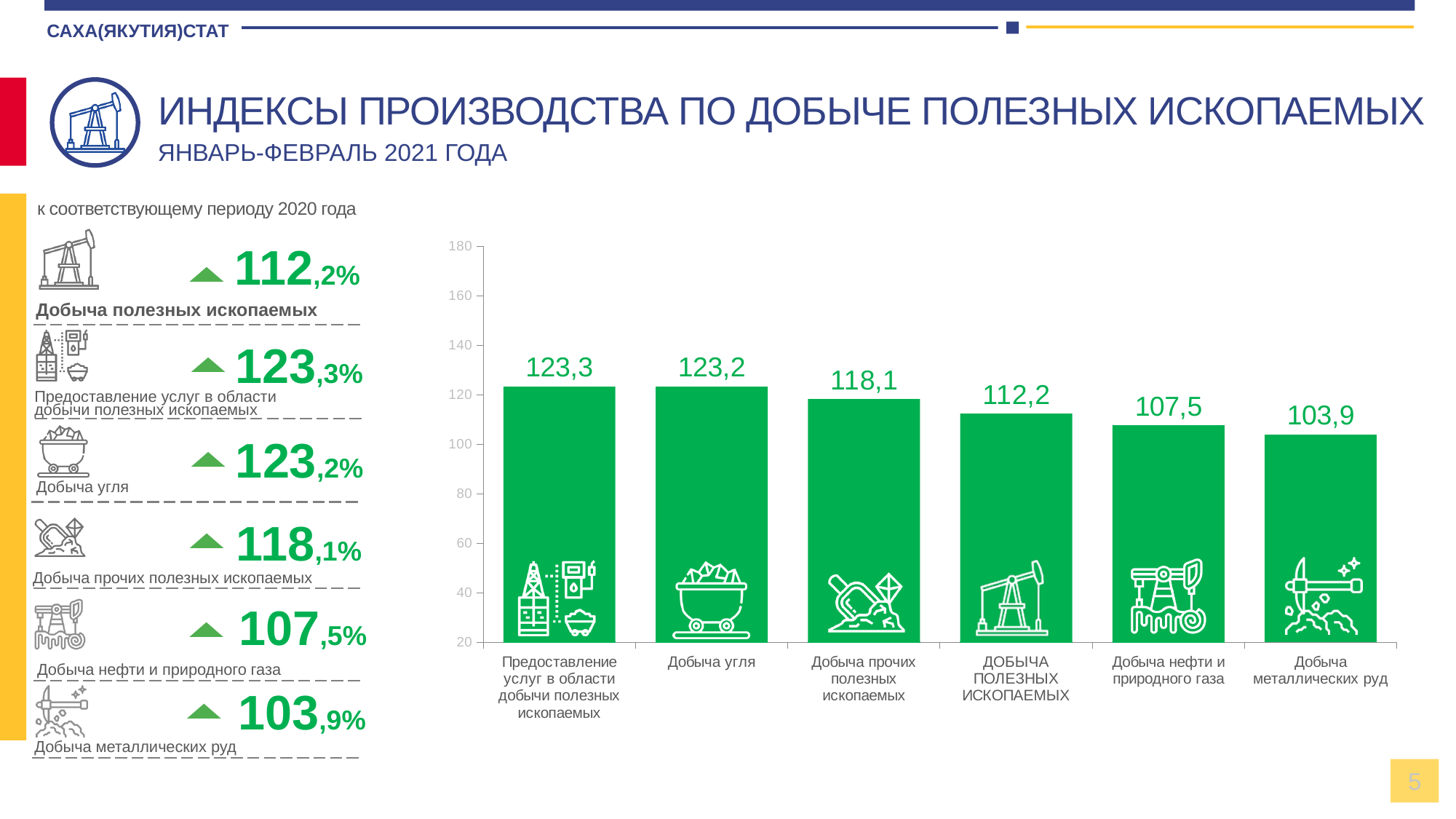
What is the value for Предоставление услуг в области добычи полезных ископаемых? 123,3 What is the value for Добыча угля? 123,2 Which category has the lowest value? Добыча металлических руд Do the values rise or fall from left to right along the x axis? fall What is the difference between the values for Добыча угля and Добыча металлических руд? 19,3 How many categories are plotted in the bar chart? 6 What is the value for Добыча прочих полезных ископаемых? 118,1 What type of chart is shown on the slide? bar chart What is the value for Добыча нефти и природного газа? 107,5 Is the value for ДОБЫЧА ПОЛЕЗНЫХ ИСКОПАЕМЫХ greater or less than 100? greater What colour are the bars in the chart? green Which is larger, the value for Добыча прочих полезных ископаемых or the value for Добыча нефти и природного газа? Добыча прочих полезных ископаемых